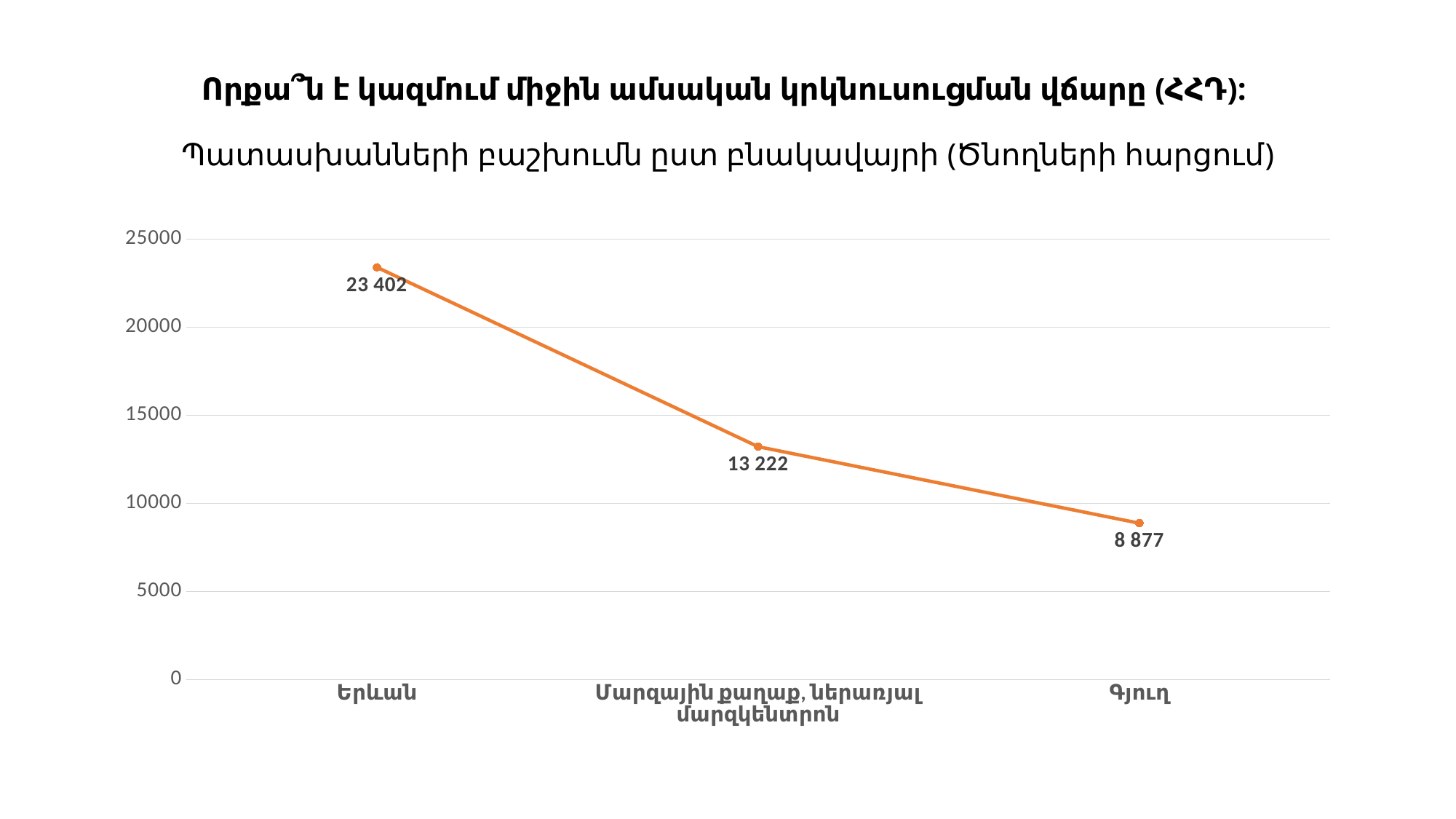
What is the difference between the values for Երևան and Մարզային քաղաք, ներառյալ մարզկենտրոն? 10 180 Which category has the lowest value? Գյուղ Which is larger: the value for Մարզային քաղաք, ներառյալ մարզկենտրոն or the value for Գյուղ? Մարզային քաղաք, ներառյալ մարզկենտրոն What kind of chart is shown on the slide? line chart What is the value for Մարզային քաղաք, ներառյալ մարզկենտրոն? 13 222 Do the values rise or fall from left to right along the x axis? fall Is the value for Գյուղ greater or less than 10000? less What is the value for Երևան? 23 402 What is the difference between the values for Երևան and Գյուղ? 14 525 How many categories are plotted on the x axis? 3 What is the value for Գյուղ? 8 877 Which category has the highest value? Երևան